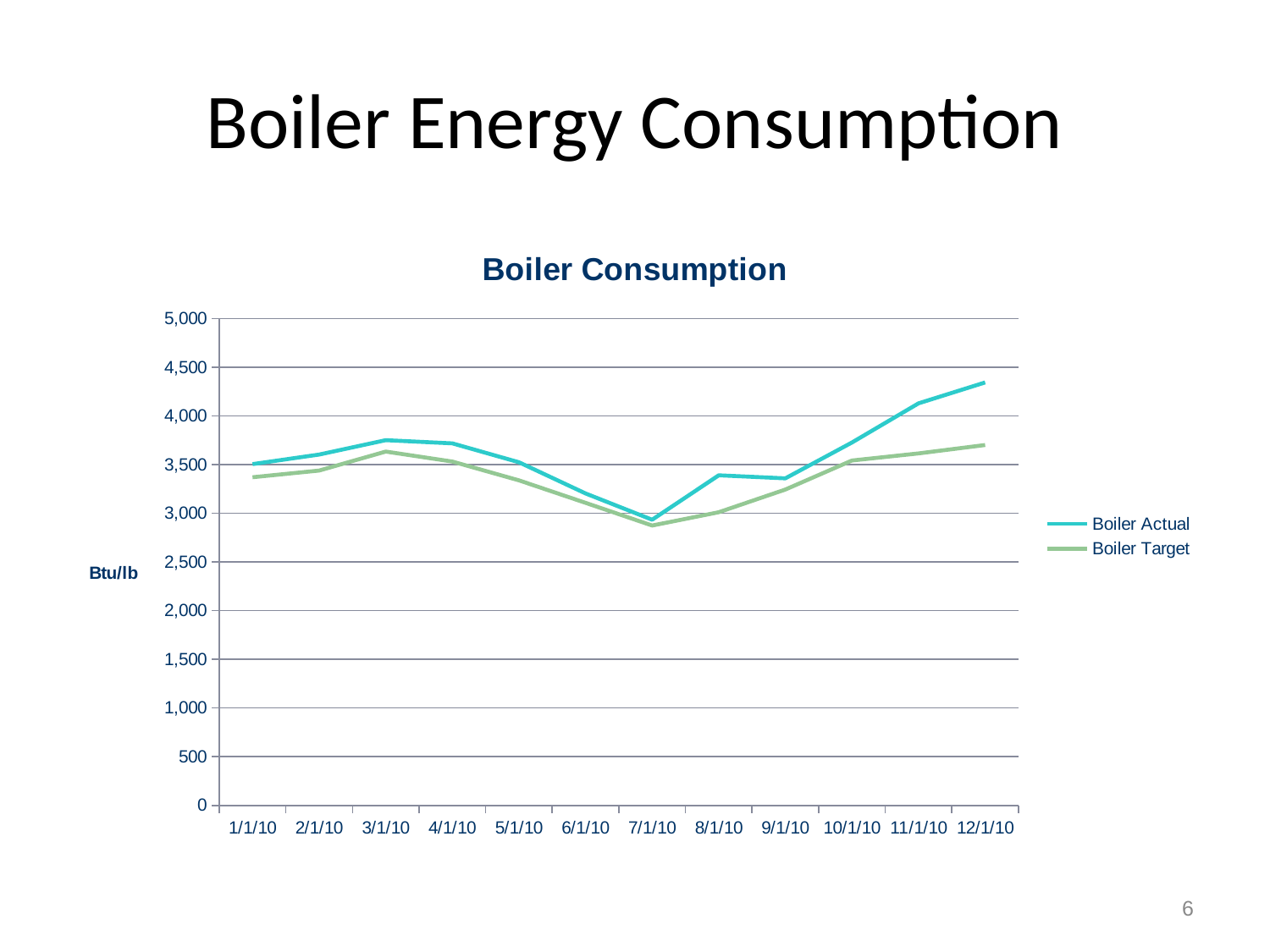
Is the Boiler Actual value for 12/1/10 greater or less than 4,000? greater What kind of chart is shown on the slide? Line chart At 12/1/10, which series has the larger value, Boiler Actual or Boiler Target? Boiler Actual On which date is the Boiler Actual value highest? 12/1/10 On which date is the Boiler Target value lowest? 7/1/10 Is the Boiler Target value for 7/1/10 greater or less than 3,000? less On which date is the Boiler Actual value lowest? 7/1/10 What unit is shown on the y axis label? Btu/lb What is the title of the chart? Boiler Consumption How many series does the legend list? 2 How many dates are shown along the x axis? 12 Does the Boiler Actual line rise or fall from 7/1/10 to 12/1/10? Rise